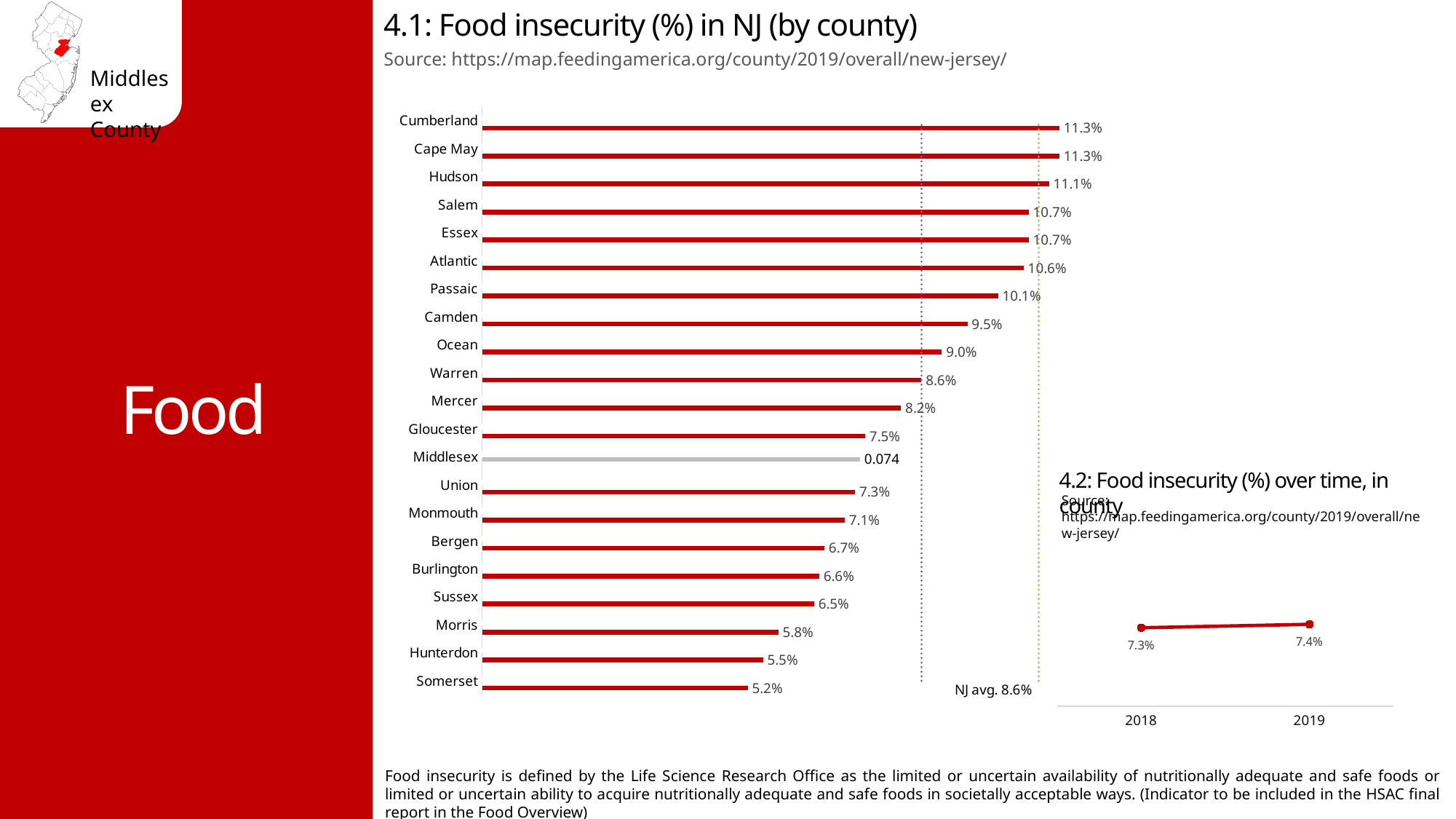
In chart 4.2 (Food insecurity (%) over time, in county), what is the difference between 2019 and 2018? 0.1% What kind of chart is chart 4.1 (Food insecurity (%) in NJ by county)? Bar chart In chart 4.2 (Food insecurity (%) over time, in county), what is the value for 2019? 7.4% In chart 4.1 (Food insecurity (%) in NJ by county), which is larger, Passaic or Mercer? Passaic In chart 4.1 (Food insecurity (%) in NJ by county), what is the value for Hudson? 11.1% In chart 4.1 (Food insecurity (%) in NJ by county), which county has the lowest value? Somerset In chart 4.1 (Food insecurity (%) in NJ by county), what data label is shown for Middlesex? 0.074 In chart 4.1 (Food insecurity (%) in NJ by county), what is the difference between Camden and Ocean? 0.5% In chart 4.1 (Food insecurity (%) in NJ by county), what NJ average is indicated? 8.6% In chart 4.2 (Food insecurity (%) over time, in county), do values rise or fall from 2018 to 2019? Rise In chart 4.1 (Food insecurity (%) in NJ by county), how many counties are plotted? 21 In chart 4.1 (Food insecurity (%) in NJ by county), what is the value for Somerset? 5.2%